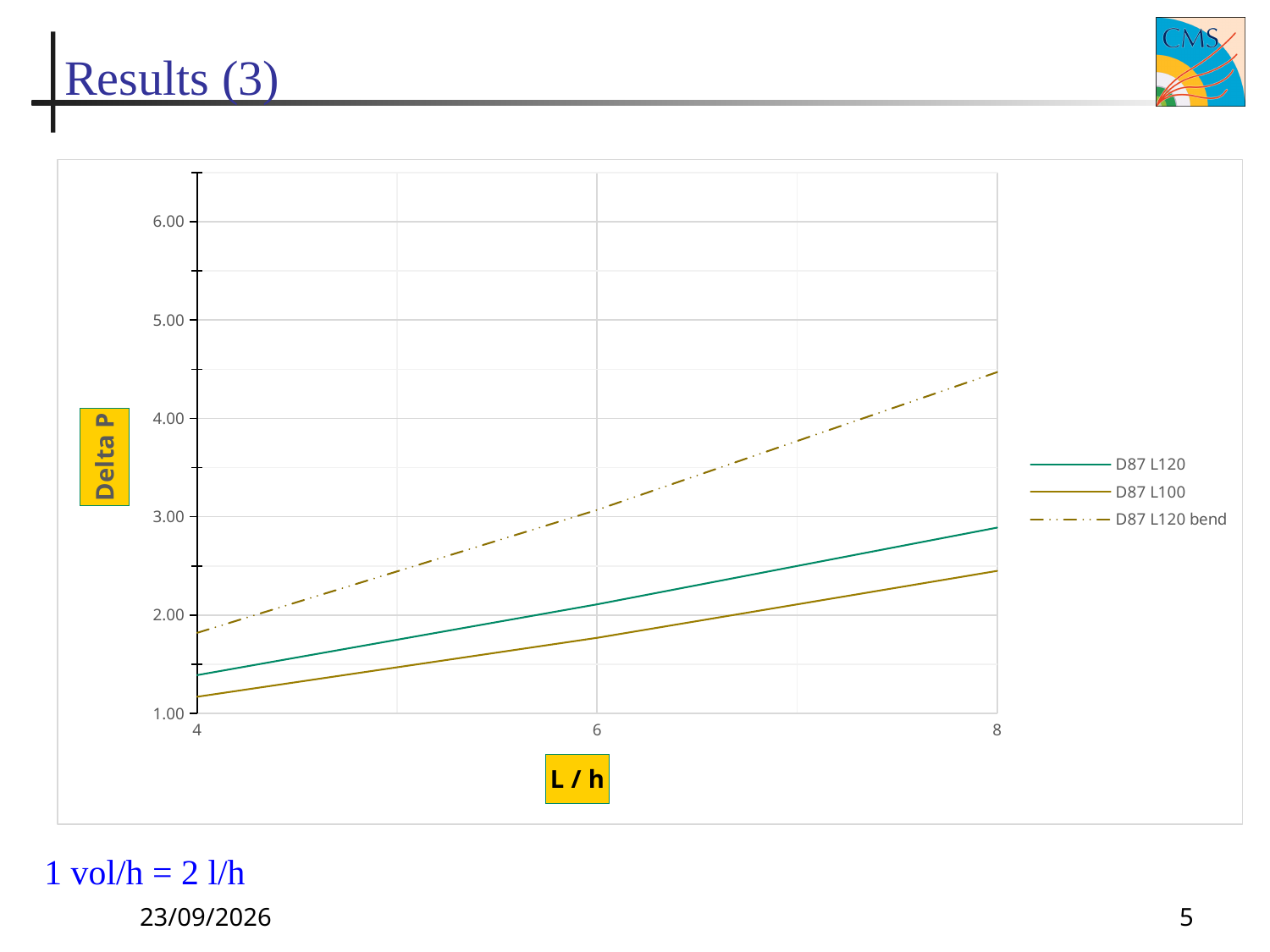
What is the title of the x axis? L / h Which series has the lowest Delta P at L/h = 8? D87 L100 At L/h = 4, which is larger: D87 L120 or D87 L100? D87 L120 Is the value for D87 L120 bend at L/h = 8 greater or less than 4.00? greater At L/h = 8, which is larger: D87 L120 bend or D87 L120? D87 L120 bend What kind of chart is shown on the slide? line chart How many series does the legend list? 3 Does Delta P for D87 L120 rise or fall as L/h increases from 4 to 8? rise Which series is plotted with a dash-dot line? D87 L120 bend Which series has the highest Delta P at L/h = 8? D87 L120 bend Which series has the lowest Delta P at L/h = 4? D87 L100 Is the value for D87 L100 at L/h = 8 greater or less than 3.00? less